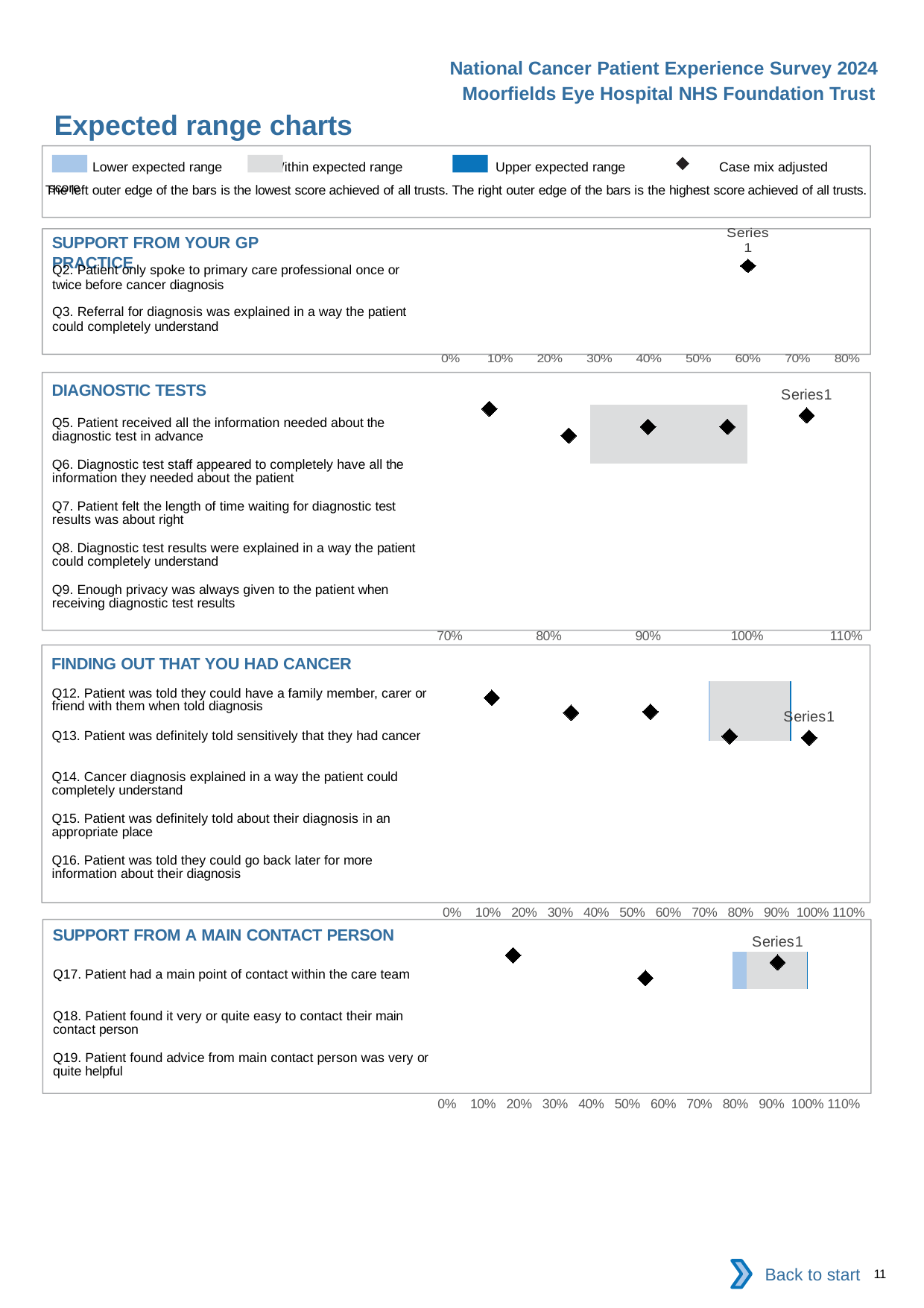
On the SUPPORT FROM YOUR GP PRACTICE chart, is the value of the plotted diamond marker greater or less than 70%? less How many diamond markers are plotted on the FINDING OUT THAT YOU HAD CANCER chart? 5 On the SUPPORT FROM YOUR GP PRACTICE chart, is the value of the plotted diamond marker greater or less than 50%? greater On the DIAGNOSTIC TESTS chart, is the leftmost diamond marker greater or less than 80%? less What is the lowest value shown on the x axis of the DIAGNOSTIC TESTS chart? 70% What is the highest value shown on the x axis of the SUPPORT FROM YOUR GP PRACTICE chart? 80% How many diamond markers are plotted on the SUPPORT FROM A MAIN CONTACT PERSON chart? 3 How many diamond markers are plotted on the DIAGNOSTIC TESTS chart? 5